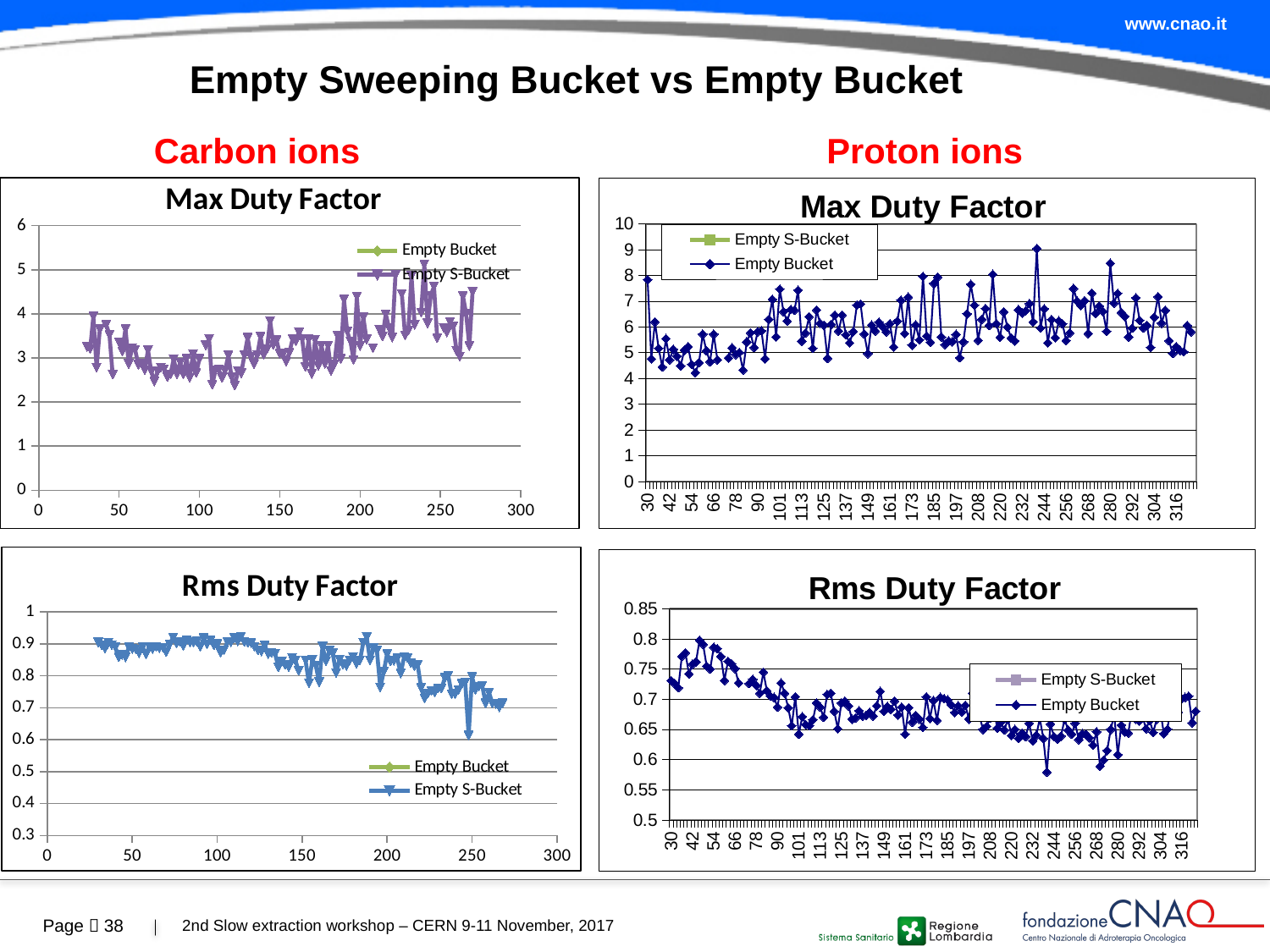
In the Proton ions Max Duty Factor chart (top-right), is the highest plotted value greater or less than 8? greater In the Proton ions Rms Duty Factor chart (bottom-right), do the values generally rise or fall from the left of the x axis to the right? fall How many series does the legend of the Proton ions Max Duty Factor chart (top-right) list? 2 In the Carbon ions Rms Duty Factor chart (bottom-left), do the values generally rise or fall as x increases from 50 to 250? fall What type of chart is the Carbon ions Max Duty Factor chart (top-left)? line chart In the Carbon ions Rms Duty Factor chart (bottom-left), is the value at x = 100 greater or less than 0.8? greater What is the title of the bottom-right chart under Proton ions? Rms Duty Factor In the Carbon ions Max Duty Factor chart (top-left), are the plotted values greater or less than 2? greater What are the two series named in the legend of the Carbon ions Rms Duty Factor chart (bottom-left)? Empty Bucket and Empty S-Bucket In the Carbon ions Max Duty Factor chart (top-left), do the values generally rise or fall between x = 150 and x = 250? rise How many series does the legend of the Carbon ions Max Duty Factor chart (top-left) list? 2